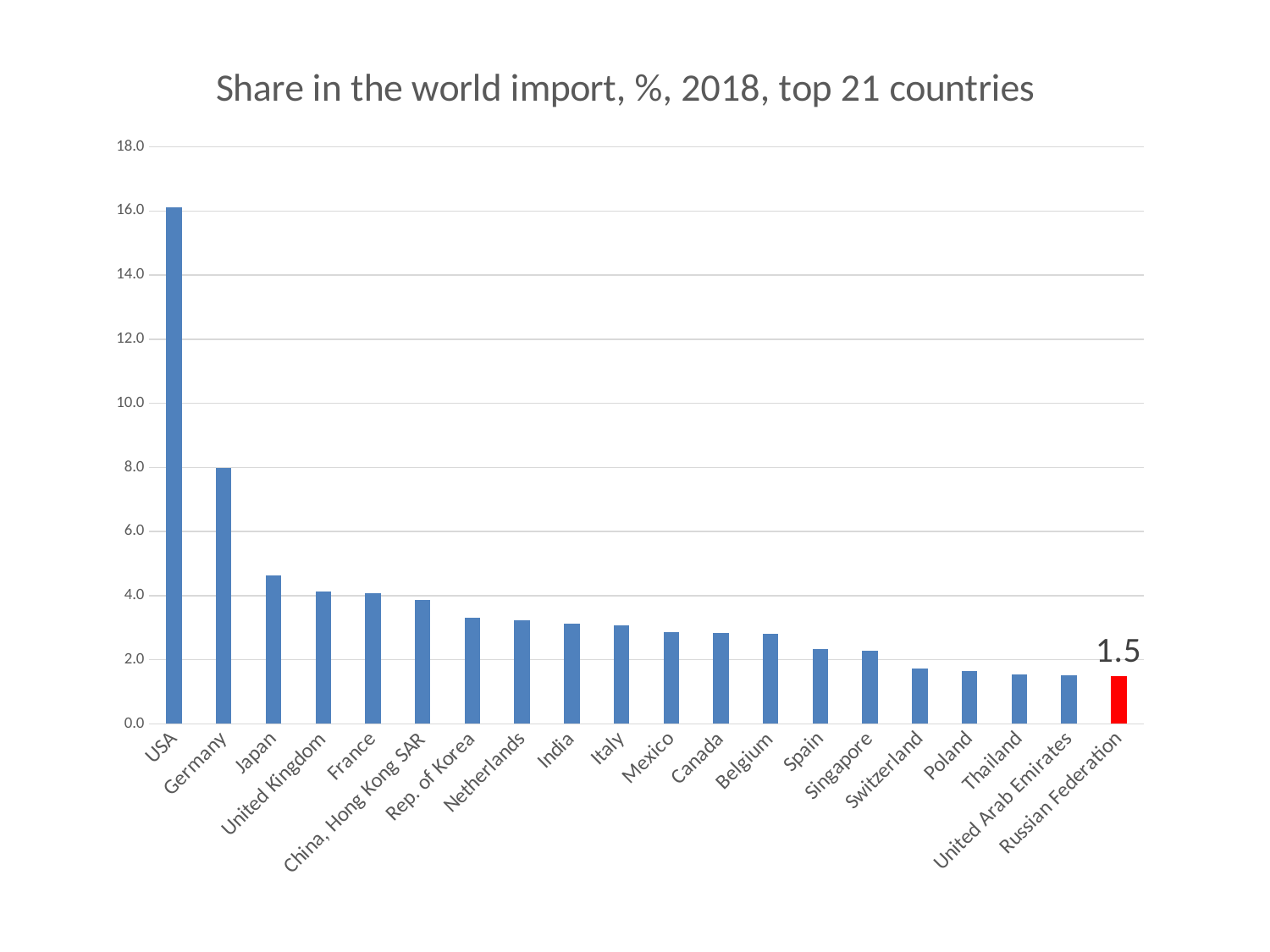
What is the value shown for Russian Federation? 1.5 What kind of chart is shown on the slide? bar chart What is the title of the chart? Share in the world import, %, 2018, top 21 countries Is the value for Japan greater or less than 4.0? greater How many countries are shown in the chart? 20 Which is larger, the value for Poland or the value for Singapore? Singapore Is the value for USA greater or less than 14.0? greater Which country has the lowest share in the world import? Russian Federation Is the value for Rep. of Korea greater or less than 4.0? less Which is larger, the value for Germany or the value for Japan? Germany Which country has the highest share in the world import? USA